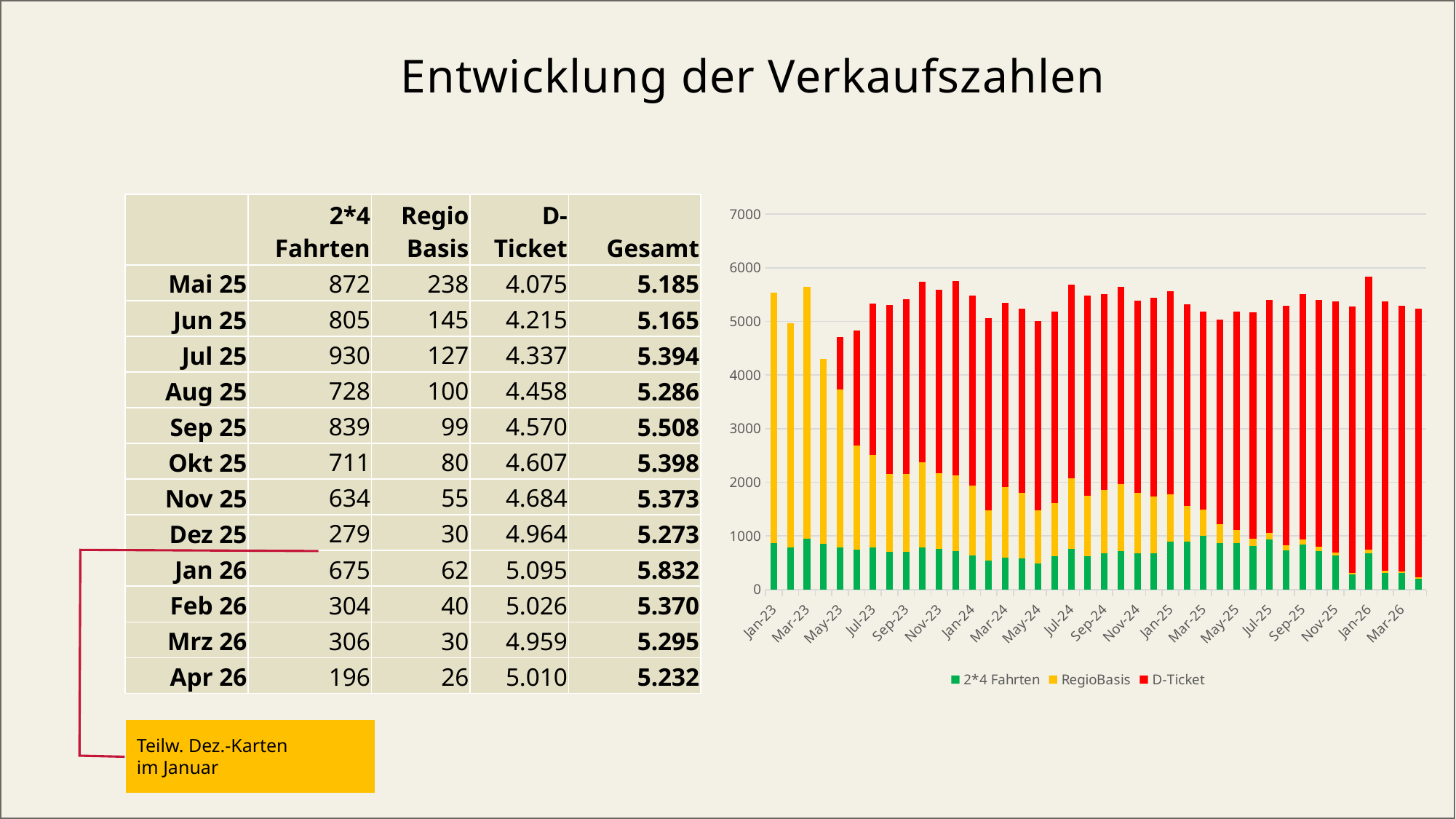
Does the RegioBasis (yellow) segment rise or fall over time from Jan-23 to Mar-26? fall Is the total height of the May-23 bar greater or less than 5000? less Which bar is taller, Jan-23 or May-23? Jan-23 Is the total height of the Jan-23 bar greater or less than 5000? greater Which month has the lowest total bar in the chart? Apr-23 What kind of chart is shown on the right of the slide? stacked bar chart What is the highest value shown on the chart's vertical axis? 7000 Does the D-Ticket (red) segment rise or fall over time from May-23 to Mar-26? rise According to the table on the slide, what is the Gesamt total for Jan 26? 5.832 Which series forms the bottom (green) segment of each stacked bar? 2*4 Fahrten Which series is shown in red in the chart? D-Ticket How many series does the chart legend list? 3